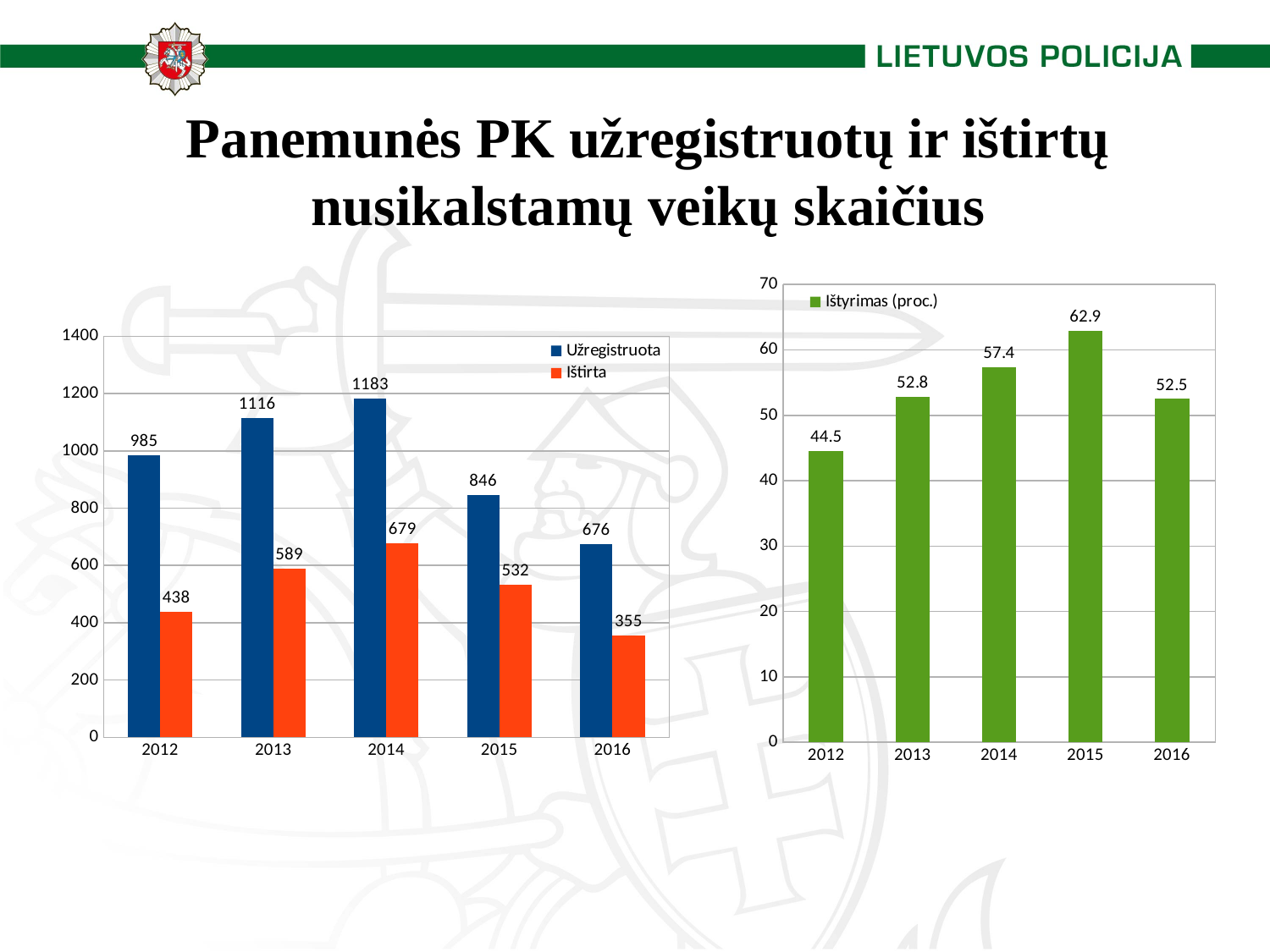
In the left chart, what is the Užregistruota value for 2014? 1183 In the right chart, which year has the lowest Ištyrimas (proc.) value? 2012 In the left chart, what is the difference between Užregistruota and Ištirta in 2012? 547 What kind of chart is the right chart? Bar chart In the right chart, what is the Ištyrimas (proc.) value for 2015? 62.9 How many series does the legend of the left chart list? 2 How many years are shown on the x axis of the right chart? 5 In the left chart, which year has the highest Ištirta value? 2014 In the left chart, which year has the lowest Užregistruota value? 2016 In the left chart, is the Ištirta value for 2015 larger than the Ištirta value for 2016? Yes In the right chart, what is the difference between the 2014 and 2013 values? 4.6 In the left chart, what is the Ištirta value for 2013? 589